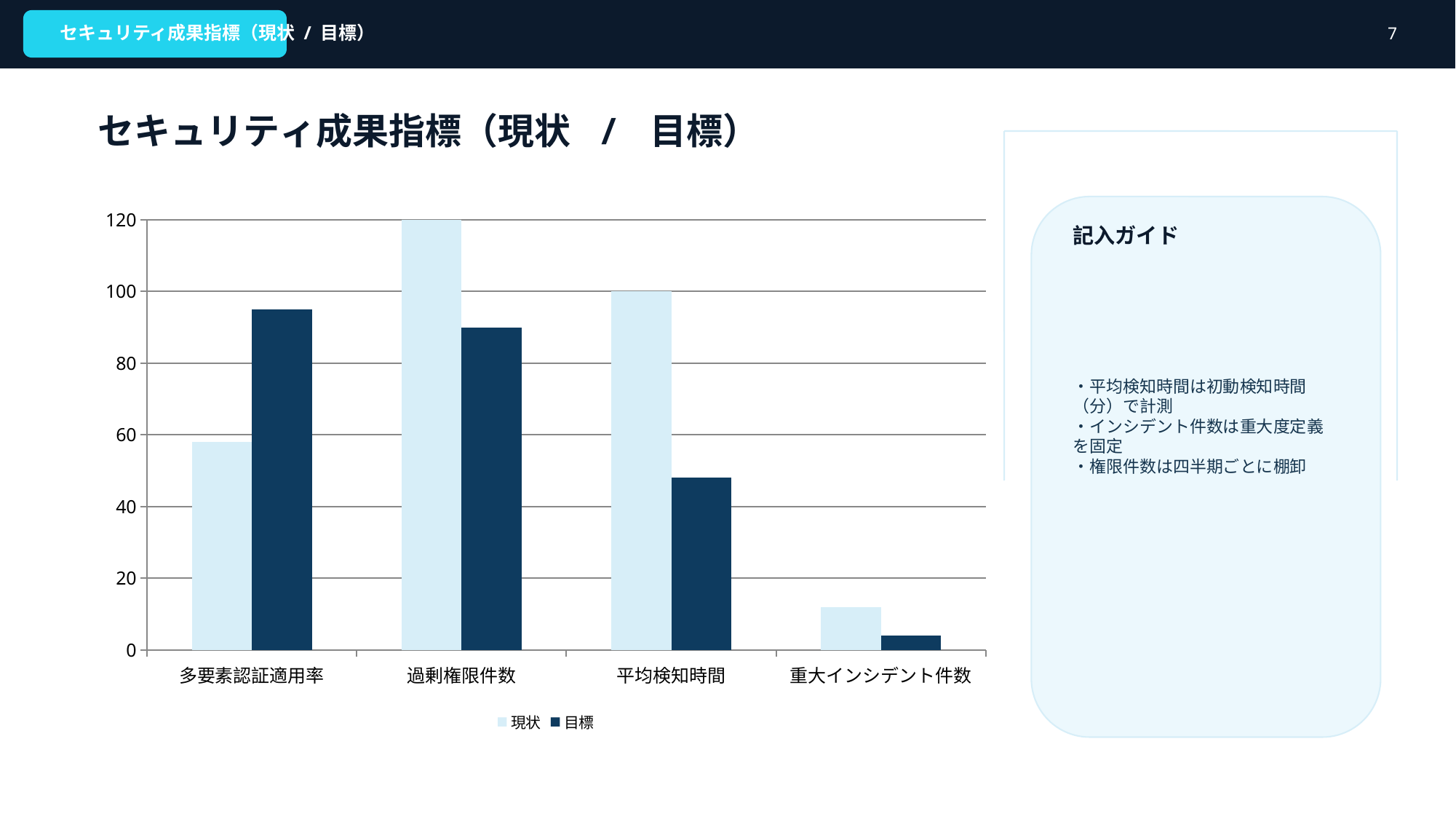
Which category has the lowest 目標 value? 重大インシデント件数 What is the 現状 value for 平均検知時間? 100 Which category has the highest 現状 value? 過剰権限件数 Is the 現状 value for 重大インシデント件数 greater or less than 20? less Is the 目標 value for 平均検知時間 greater or less than 60? less For 多要素認証適用率, which is larger, the 現状 value or the 目標 value? 目標 How many series does the chart legend list? 2 Is the 現状 value for 多要素認証適用率 greater or less than 40? greater How many categories are shown on the x axis of the chart? 4 What kind of chart is shown on the slide? bar chart What are the two series named in the chart legend? 現状 and 目標